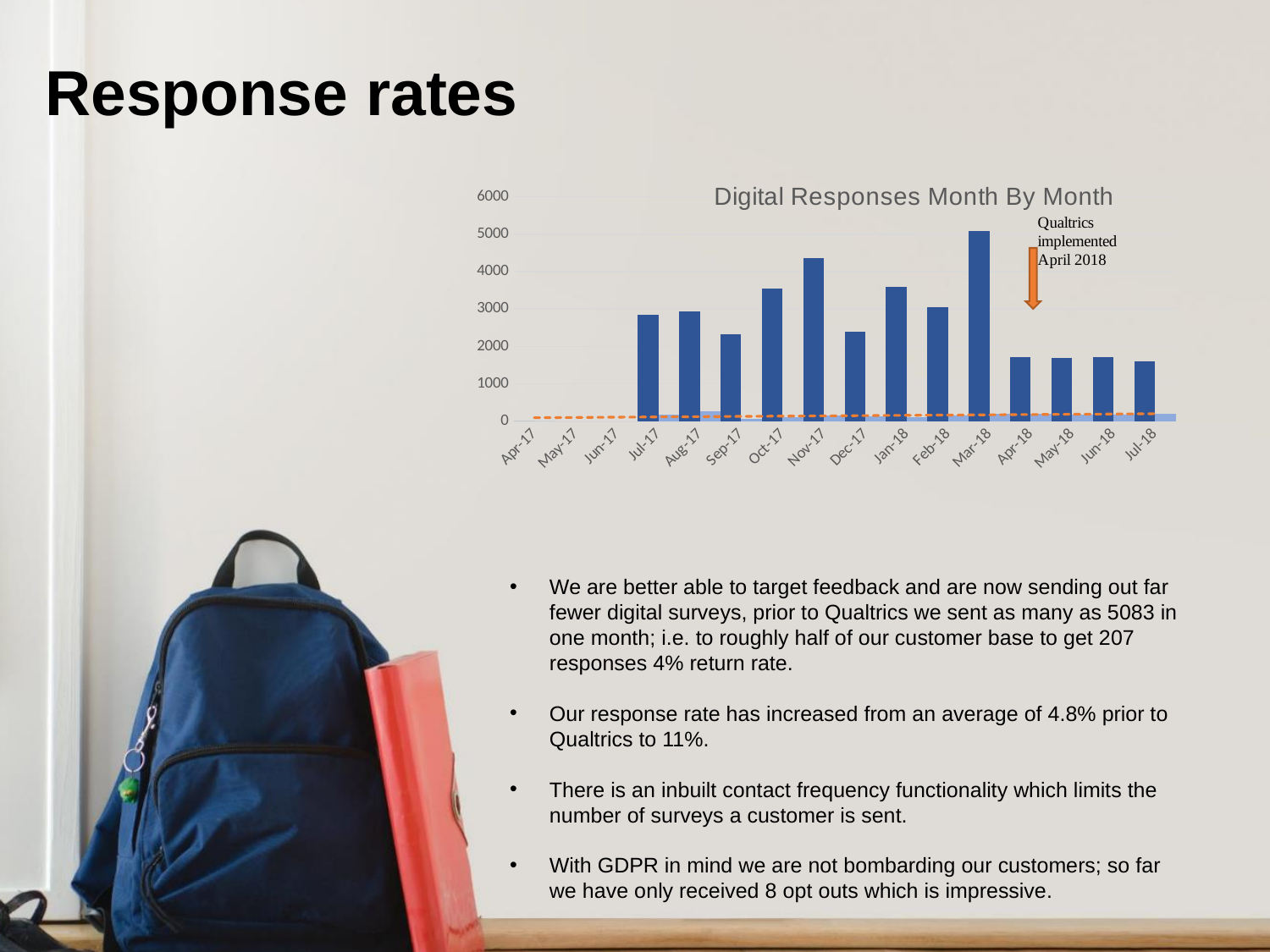
Is the value for Jul-18 greater or less than 2000? less Which month has the larger value, Oct-17 or Nov-17? Nov-17 Which month has the highest bar in the chart? Mar-18 Is the value for Mar-18 greater or less than 4000? greater What is the title of the chart? Digital Responses Month By Month Is the value for Sep-17 greater or less than 3000? less What type of chart is shown on the slide? Bar chart Which month has the larger value, Mar-18 or Apr-18? Mar-18 How many months are listed along the x axis of the chart? 16 What event does the annotation with the orange arrow on the chart mark? Qualtrics implemented April 2018 Do the bar values rise or fall from Mar-18 to Jul-18? Fall